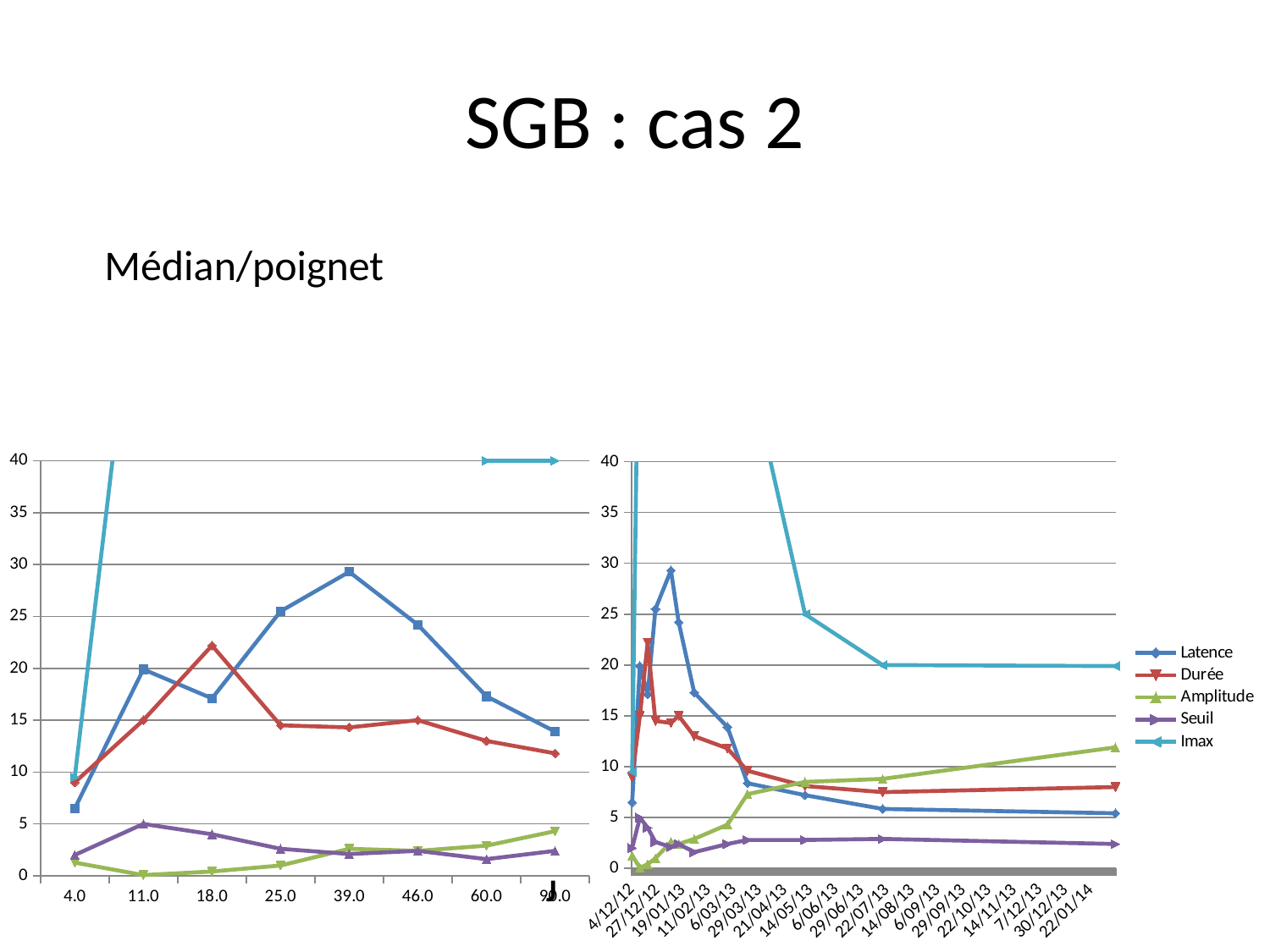
How many x-axis categories does the left chart show? 8 How many series does the legend of the right chart list? 5 What kind of chart is the left chart on the slide? line chart What is the title of the slide containing the charts? SGB : cas 2 In the right chart, is the value of Durée at 22/01/14 greater or less than 10? less In the right chart, is the value of Amplitude at 22/01/14 greater or less than 10? greater In the left chart, is the value of the blue line at 39.0 greater or less than 25? greater In the left chart, does the blue line rise or fall from 39.0 to 90.0? fall In the right chart, does the Amplitude line rise or fall from 29/03/13 to 22/01/14? rise